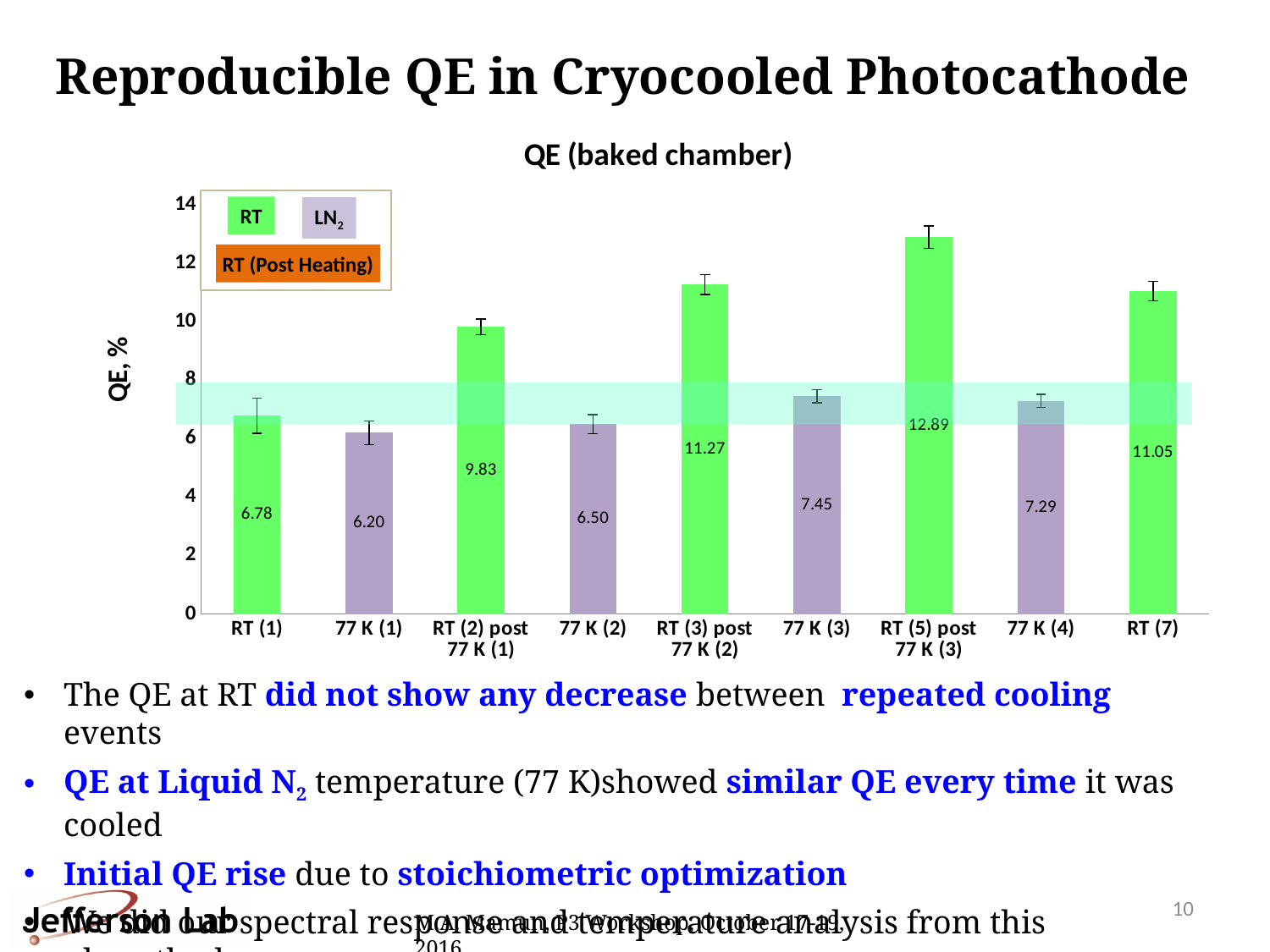
Which category has the highest QE value? RT (5) post 77 K (3) What is the QE value for RT (5) post 77 K (3)? 12.89 What is the title of the chart? QE (baked chamber) What is the QE value for RT (1)? 6.78 What kind of chart is shown on the slide? bar chart How many series does the legend list? 3 Which is larger, the QE value for 77 K (4) or for 77 K (1)? 77 K (4) What is the QE value for RT (7)? 11.05 What is the QE value for 77 K (3)? 7.45 What is the difference between the QE values for RT (3) post 77 K (2) and 77 K (2)? 4.77 How many categories are shown on the x axis? 9 Which category has the lowest QE value? 77 K (1)